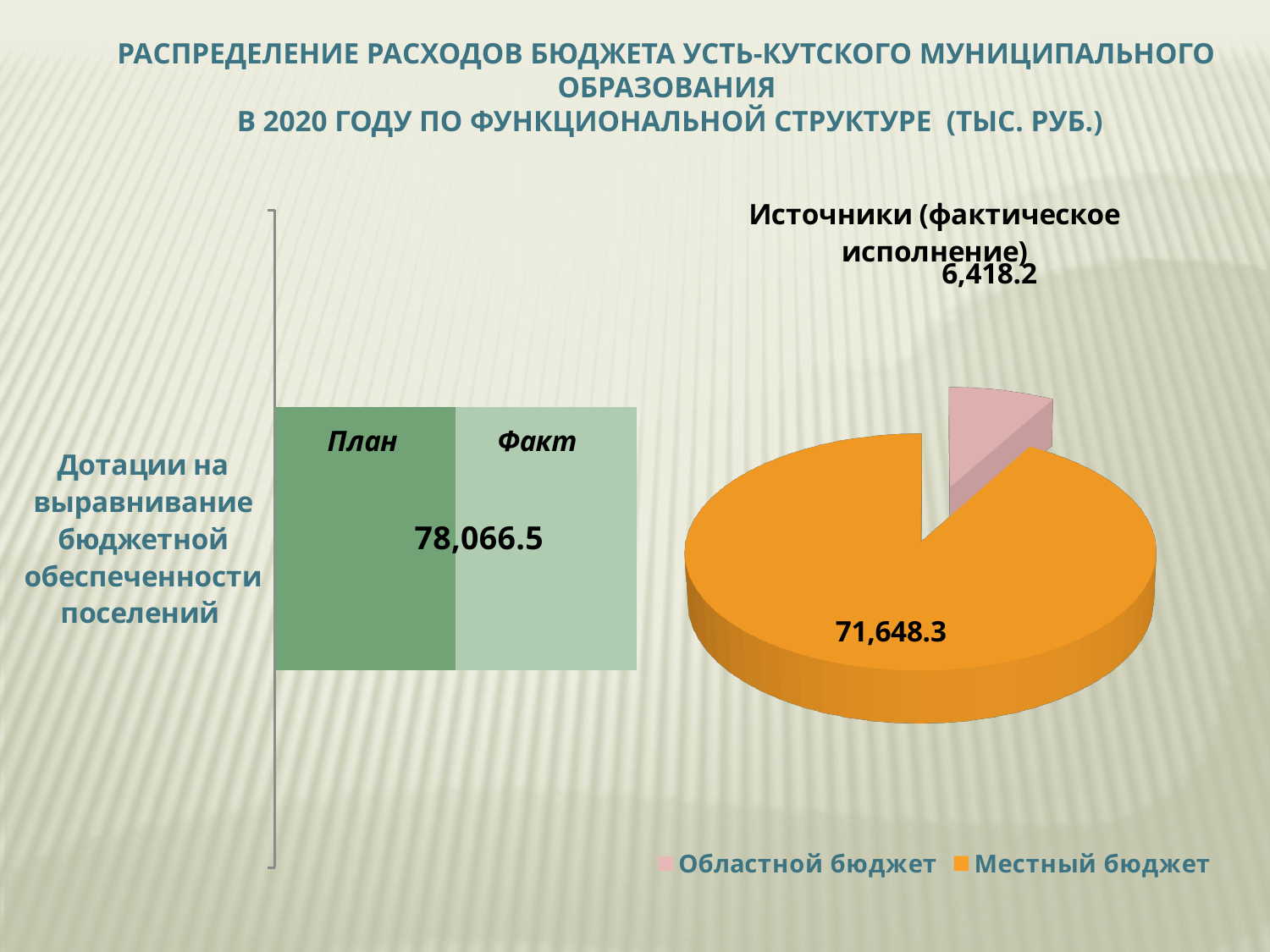
How many entries does the legend of the pie chart on the right list? 2 In the pie chart on the right, which is larger: Областной бюджет or Местный бюджет? Местный бюджет What kind of chart is the chart on the left of the slide? Bar chart What kind of chart is the chart on the right of the slide? Pie chart In the pie chart on the right, which source has the largest slice? Местный бюджет In the bar chart on the left, what are the two bars labelled? План and Факт In the pie chart on the right, which source has the smallest slice? Областной бюджет In the pie chart titled 'Источники (фактическое исполнение)', what is the value for Местный бюджет? 71,648.3 In the bar chart on the left, what value is printed on the bars for 'Дотации на выравнивание бюджетной обеспеченности поселений'? 78,066.5 In the pie chart titled 'Источники (фактическое исполнение)', what is the value for Областной бюджет? 6,418.2 In the pie chart on the right, what is the total of the two slices? 78,066.5 In the pie chart on the right, what is the difference between the Местный бюджет and Областной бюджет values? 65,230.1